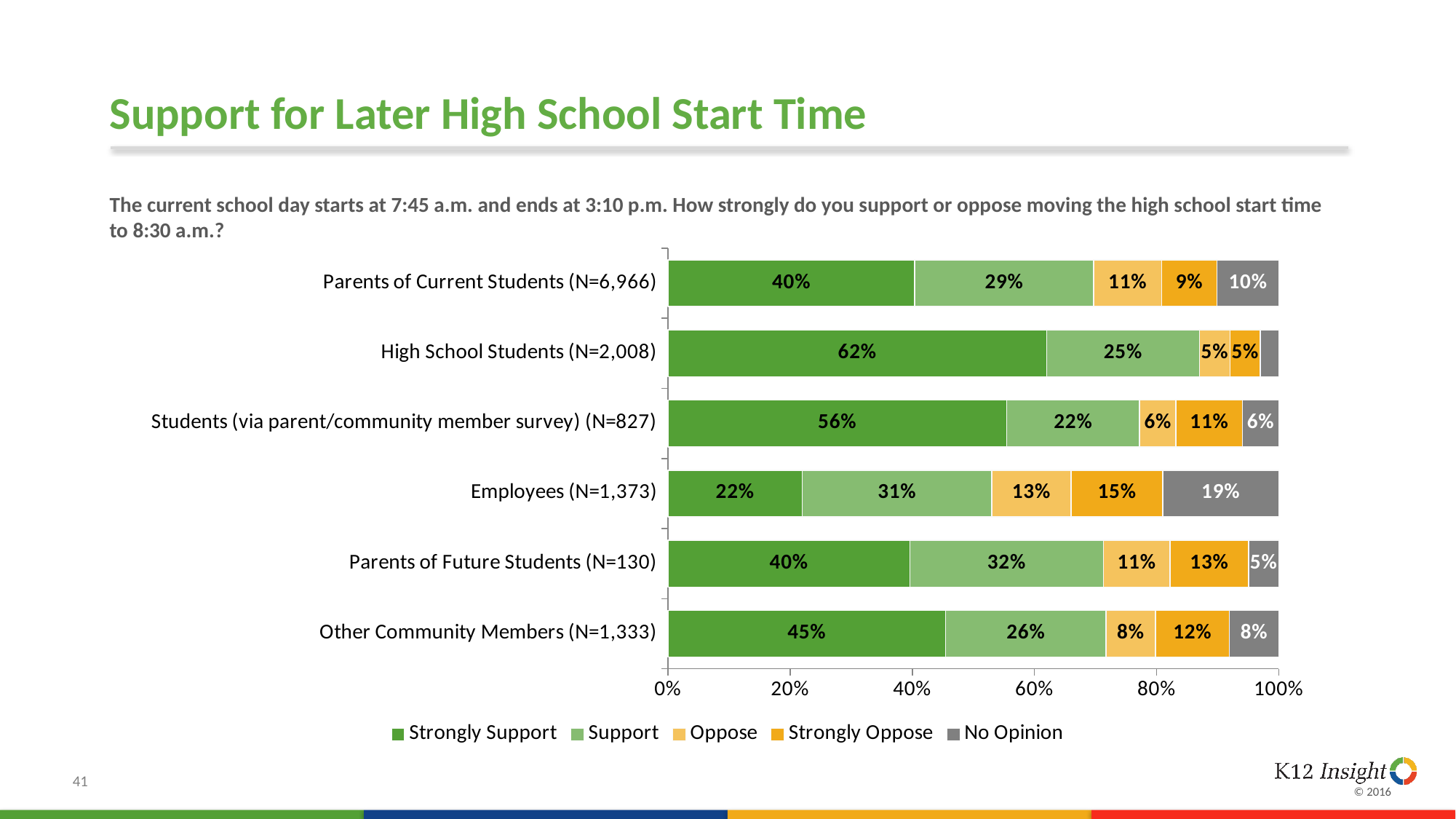
Which group has the lowest Strongly Support percentage? Employees (N=1,373) What is the Oppose value for Students (via parent/community member survey) (N=827)? 6% How many series does the legend list? 5 What percentage of High School Students (N=2,008) Strongly Support moving the start time? 62% What type of chart is shown on the slide? Stacked bar chart How many percentage points higher is Strongly Support for Other Community Members (N=1,333) than for Parents of Current Students (N=6,966)? 5 percentage points What colour represents No Opinion in the legend? Grey Which group has the highest No Opinion percentage? Employees (N=1,373) What is the No Opinion value for Employees (N=1,373)? 19% Which has a larger Strongly Oppose value: Employees (N=1,373) or Parents of Current Students (N=6,966)? Employees (N=1,373) How many respondent groups are shown in the chart? 6 Which group has the highest Strongly Support percentage? High School Students (N=2,008)